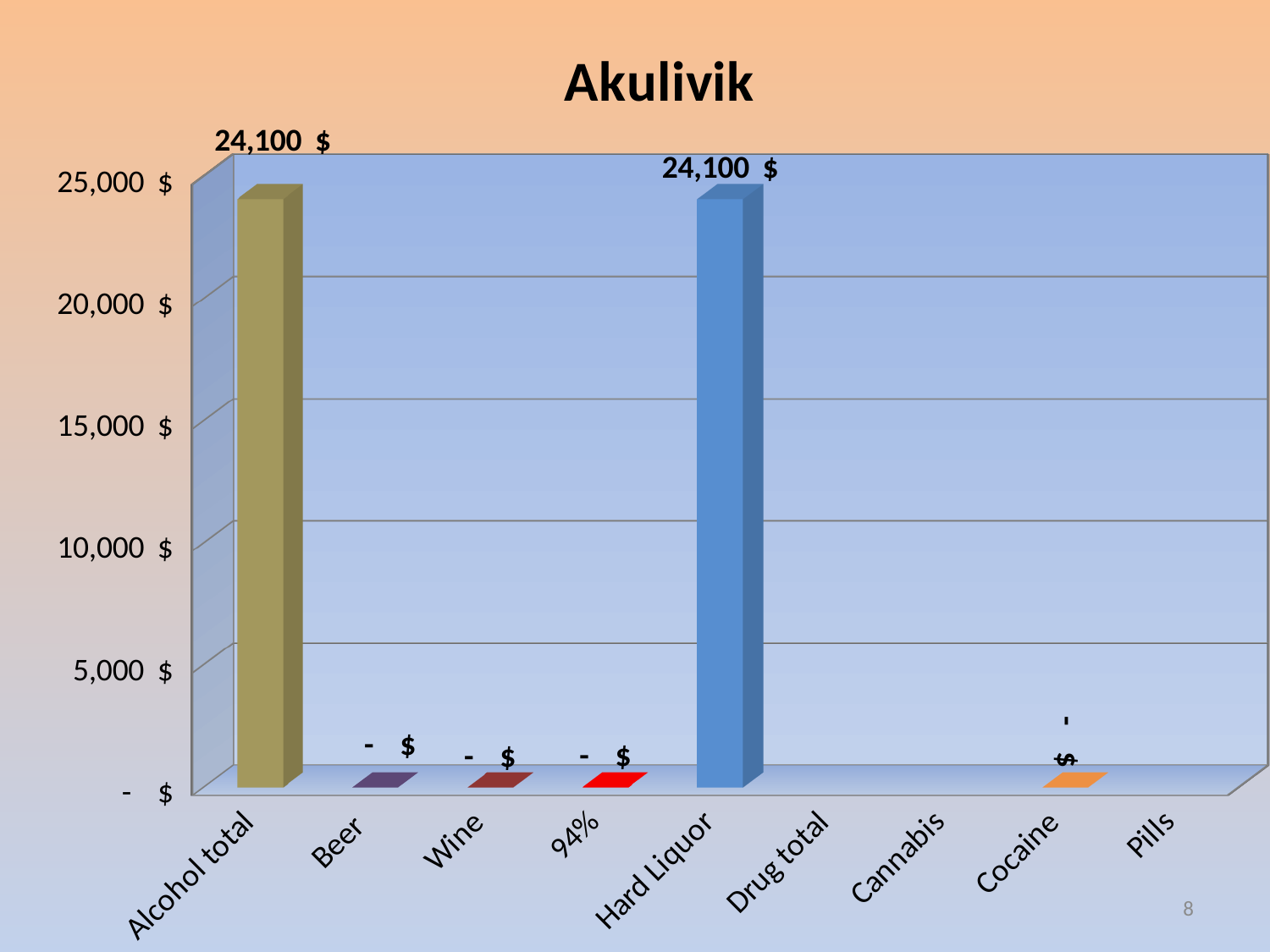
What kind of chart is shown on the slide? Bar chart Is the value for Alcohol total greater or less than 25,000 $? less How many categories are shown on the x axis? 9 Which is larger, the value for Alcohol total or the value for Beer? Alcohol total What is the title of the chart? Akulivik Is the value for Hard Liquor greater or less than 20,000 $? greater Which is larger, the value for Hard Liquor or the value for Cocaine? Hard Liquor What is the value for Hard Liquor? 24,100 $ What is the value for Alcohol total? 24,100 $ What value is printed above the Wine bar? - $ What value is printed above the Beer bar? - $ What is the difference between the value for Alcohol total and the value for Hard Liquor? 0 $